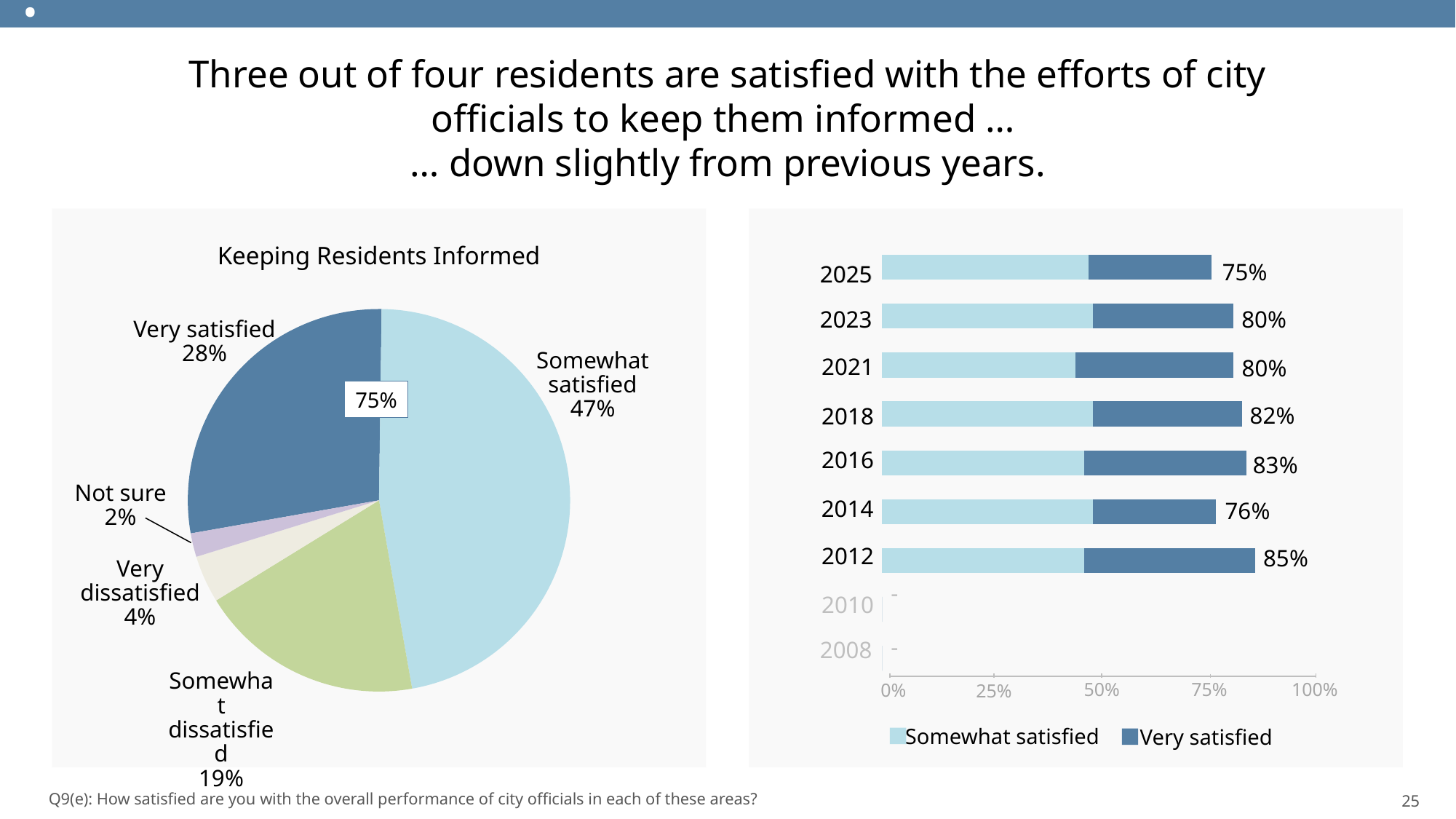
In the bar chart on the right, what is the total satisfied percentage for 2018? 82% In the pie chart 'Keeping Residents Informed', what share of residents are very dissatisfied? 4% In the pie chart 'Keeping Residents Informed', what is the difference between the very satisfied and somewhat dissatisfied shares? 9 percentage points In the pie chart 'Keeping Residents Informed', which category has the largest share? Somewhat satisfied In the pie chart 'Keeping Residents Informed', what share of residents are somewhat satisfied? 47% What kind of chart is the chart on the right side of the slide? Stacked bar chart How many series does the legend of the bar chart on the right list? 2 In the bar chart on the right, what is the difference between the 2012 and 2025 totals? 10 percentage points In the bar chart on the right, which year has the highest total satisfied percentage? 2012 In the bar chart on the right, which year has the lowest total satisfied percentage among the years with bars? 2025 In the pie chart 'Keeping Residents Informed', how many slices are labelled? 5 In the pie chart 'Keeping Residents Informed', which category has the smallest share? Not sure